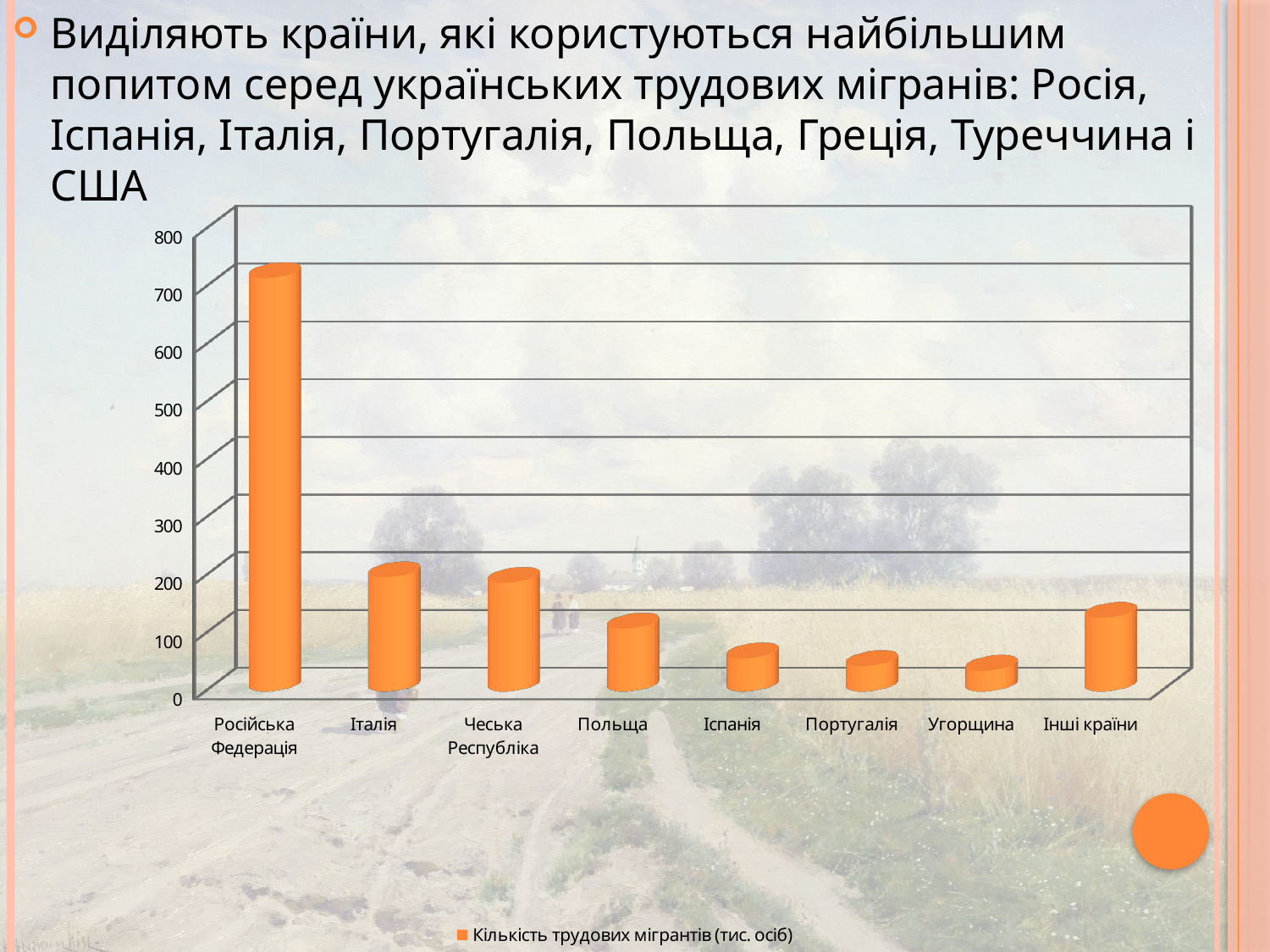
How many countries/categories are shown on the x axis of the chart? 8 Is the value for Італія greater or less than 300? less What is the legend entry of the series shown in the chart? Кількість трудових мігрантів (тис. осіб) How many series does the chart legend list? 1 Is the value for Угорщина greater or less than 100? less Is the value for Інші країни greater or less than 100? greater Which is larger, the value for Російська Федерація or the value for Італія? Російська Федерація What kind of chart is shown on the slide? bar chart Which is larger, the value for Польща or the value for Іспанія? Польща Which category has the highest value in the chart? Російська Федерація